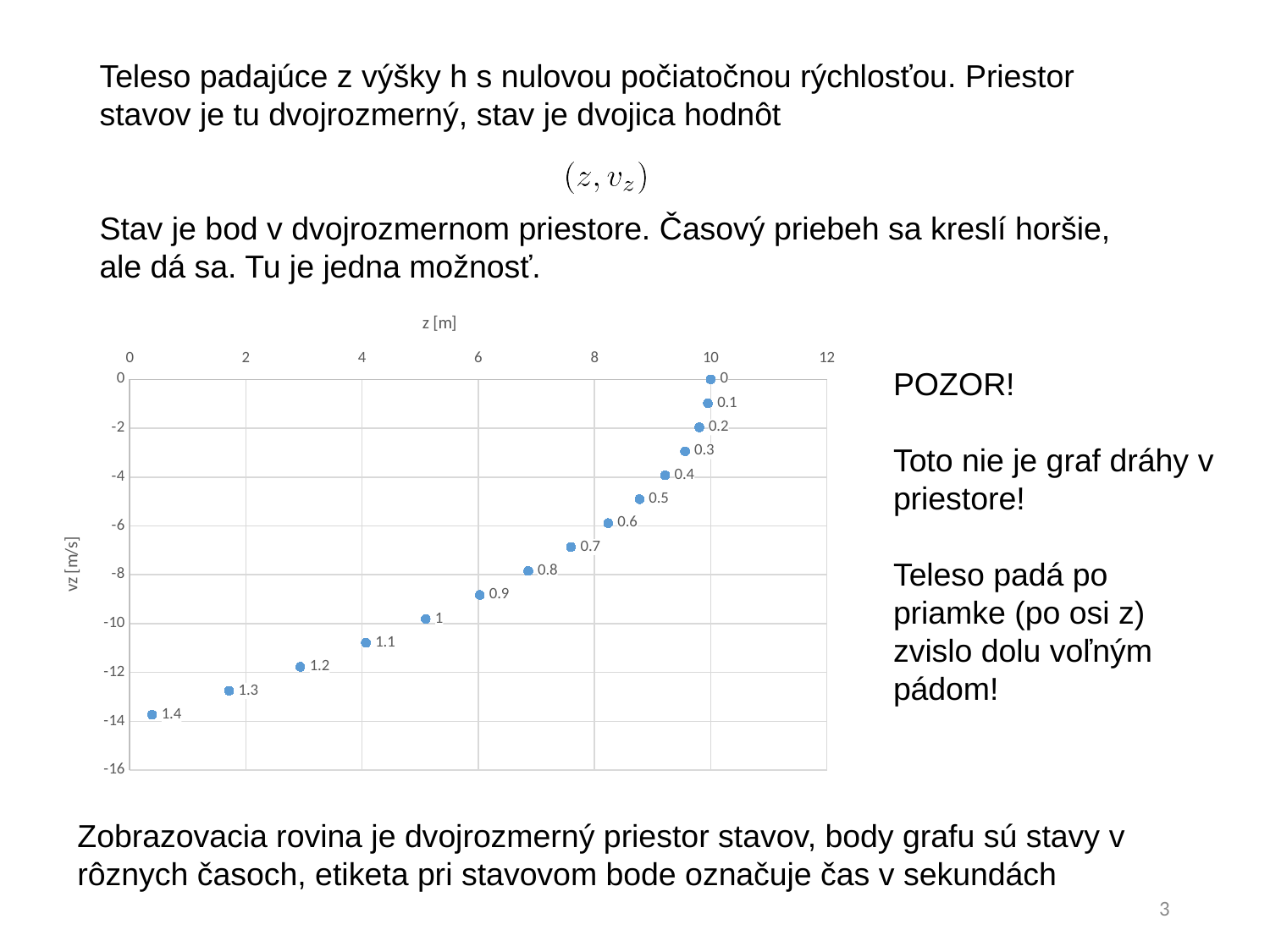
Which labeled point has the highest z value? 0 What is the vz value of the point labeled 0? 0 What is the title of the horizontal axis of the chart? z [m] What is the title of the vertical axis of the chart? vz [m/s] As z increases along the x axis, do the vz values of the points rise or fall? rise What kind of chart is shown on the slide? scatter chart Is the z value for the point labeled 1.2 greater or less than 4? less Is the z value for the point labeled 0.5 greater or less than 8? greater Which labeled point has the lowest vz value? 1.4 What is the z value of the point labeled 0? 10 Is the vz value for the point labeled 1.4 greater or less than -12? less How many data points are plotted on the chart? 15